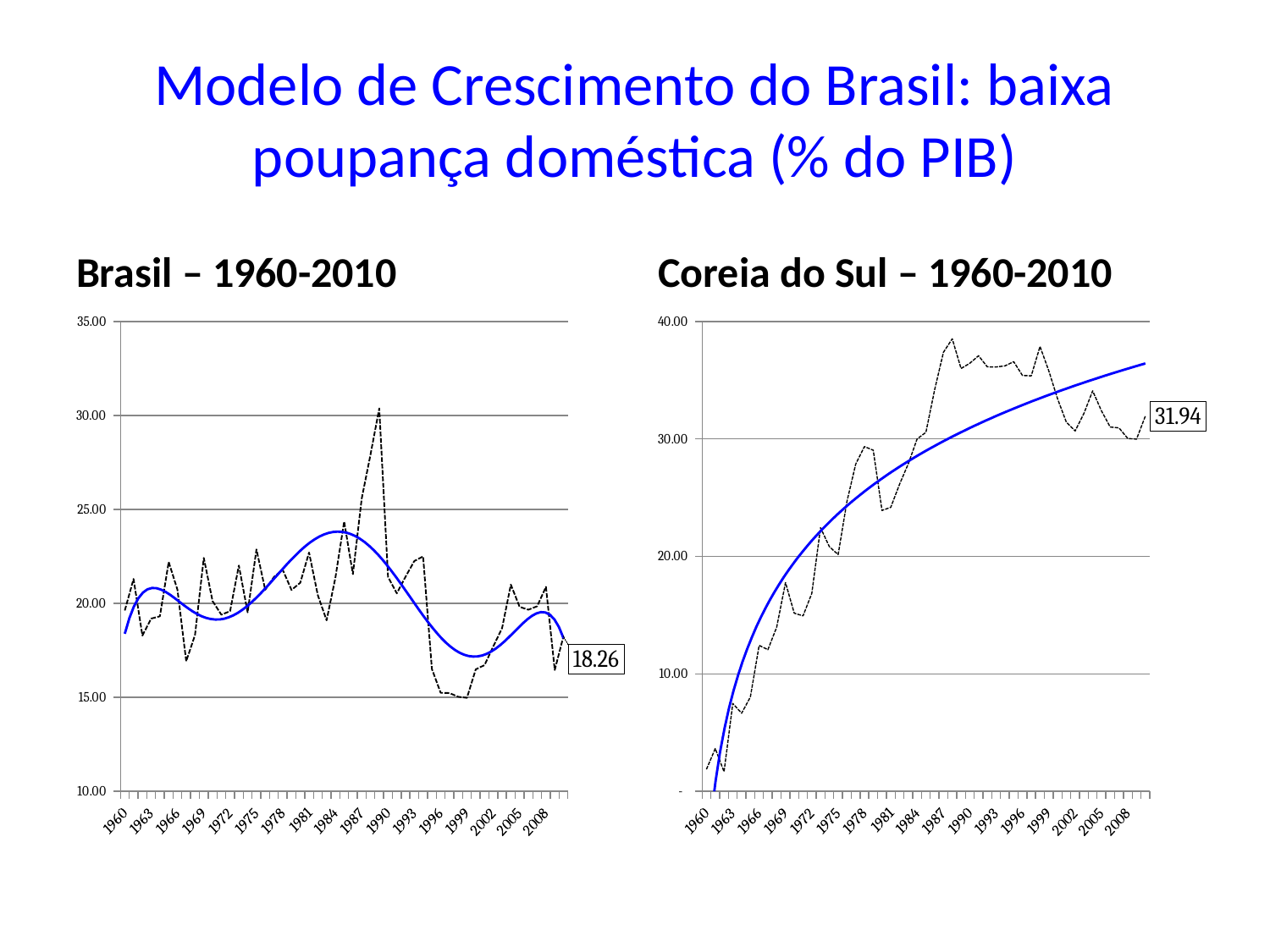
On the Coreia do Sul – 1960-2010 chart, does the smooth trend line rise or fall from 1960 to 2010? Rises On the Coreia do Sul – 1960-2010 chart, is the value for 1960 greater or less than 10.00? less What is the title of the chart on the left of the slide? Brasil – 1960-2010 Which chart has the higher labelled final value, Brasil – 1960-2010 or Coreia do Sul – 1960-2010? Coreia do Sul – 1960-2010 On the Brasil – 1960-2010 chart, is the peak value around 1989 greater or less than 25.00? greater On the Coreia do Sul – 1960-2010 chart, is the value for 1988 greater or less than 35.00? greater What is the difference between the labelled final values on the Coreia do Sul – 1960-2010 chart (31.94) and the Brasil – 1960-2010 chart (18.26)? 13.68 On the Brasil – 1960-2010 chart, what value is shown by the data label at the end of the series? 18.26 What kind of chart is the Brasil – 1960-2010 chart? Line chart What is the highest value shown on the y axis of the Coreia do Sul – 1960-2010 chart? 40.00 On the Coreia do Sul – 1960-2010 chart, what value is shown by the data label at the end of the series? 31.94